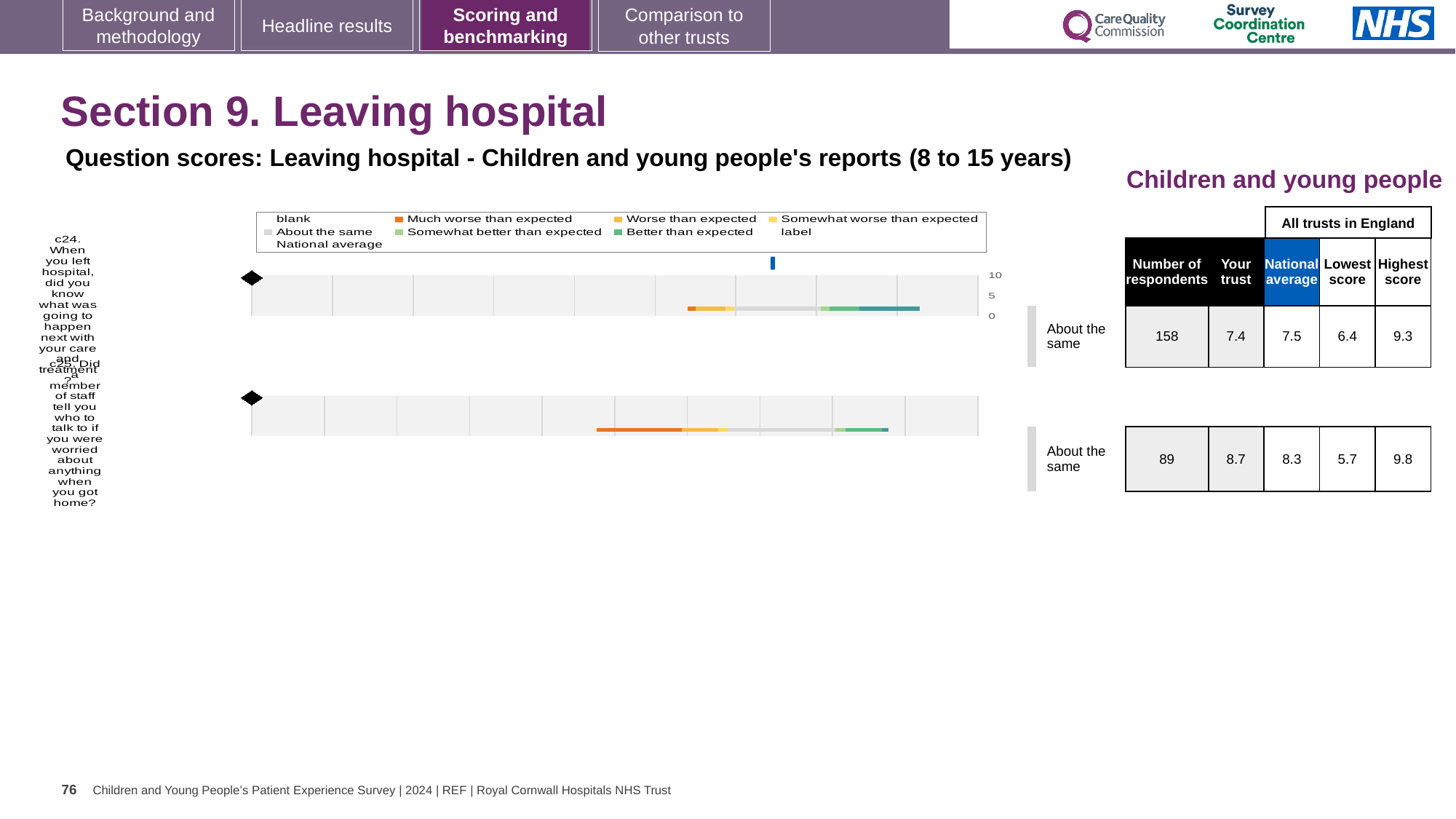
What is the 'Your trust' score for question c24 (When you left hospital, did you know what was going to happen next with your care and treatment?)? 7.4 What is the national average score for question c24? 7.5 What is the difference between the highest and lowest scores across all trusts in England for question c24? 2.9 How many respondents answered question c24? 158 What benchmark category is shown for both questions c24 and c25? About the same What kind of chart is used to show the question scores on this slide? bar chart Which question has more respondents, c24 or c25? c24 How many questions are plotted in the chart? 2 What is the difference between the trust's score and the national average for question c25? 0.4 For question c25, is the trust's score higher or lower than the national average? higher What is the highest score among all trusts in England for question c25? 9.8 What is the 'Your trust' score for question c25 (Did a member of staff tell you who to talk to if you were worried about anything when you got home?)? 8.7